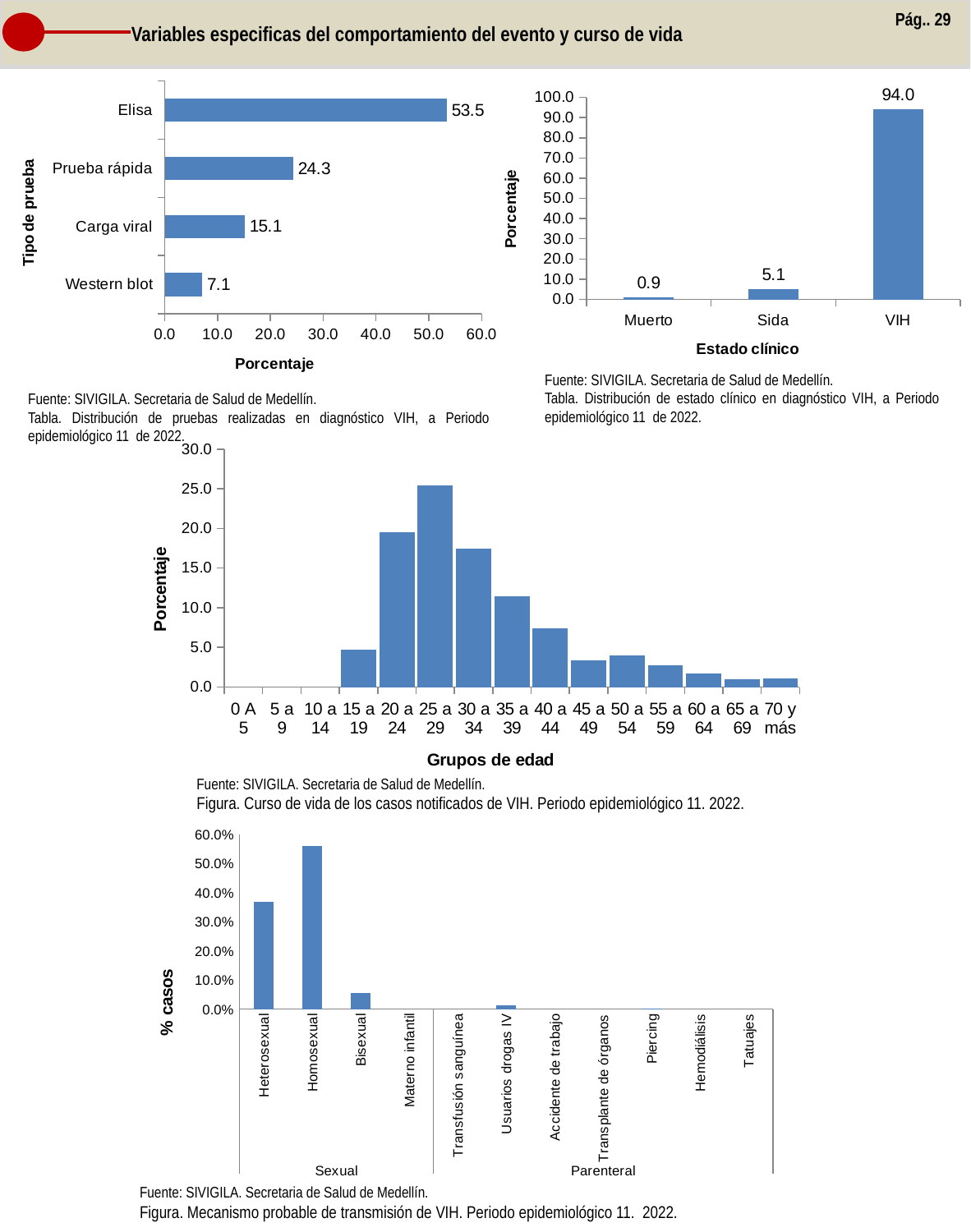
In the top-left chart of test types (Tipo de prueba), what is the value for Elisa? 53.5 In the middle chart of age groups (Grupos de edad), how many age groups are shown on the x axis? 15 In the middle chart of age groups (Grupos de edad), which age group has the highest percentage? 25 a 29 In the top-right chart of clinical status (Estado clínico), what is the value for Sida? 5.1 In the bottom chart of transmission mechanism (% casos), which category has the highest value? Homosexual In the middle chart of age groups (Grupos de edad), is the value for 20 a 24 greater or less than 15.0? greater In the top-right chart of clinical status (Estado clínico), which category has the lowest value? Muerto In the top-left chart of test types (Tipo de prueba), what is the difference between Prueba rápida and Carga viral? 9.2 In the bottom chart of transmission mechanism (% casos), is the value for Heterosexual greater or less than 30.0%? greater In the top-left chart of test types (Tipo de prueba), what is the value for Western blot? 7.1 In the top-right chart of clinical status (Estado clínico), what is the difference between VIH and Sida? 88.9 In the top-left chart of test types (Tipo de prueba), how many test types are shown? 4